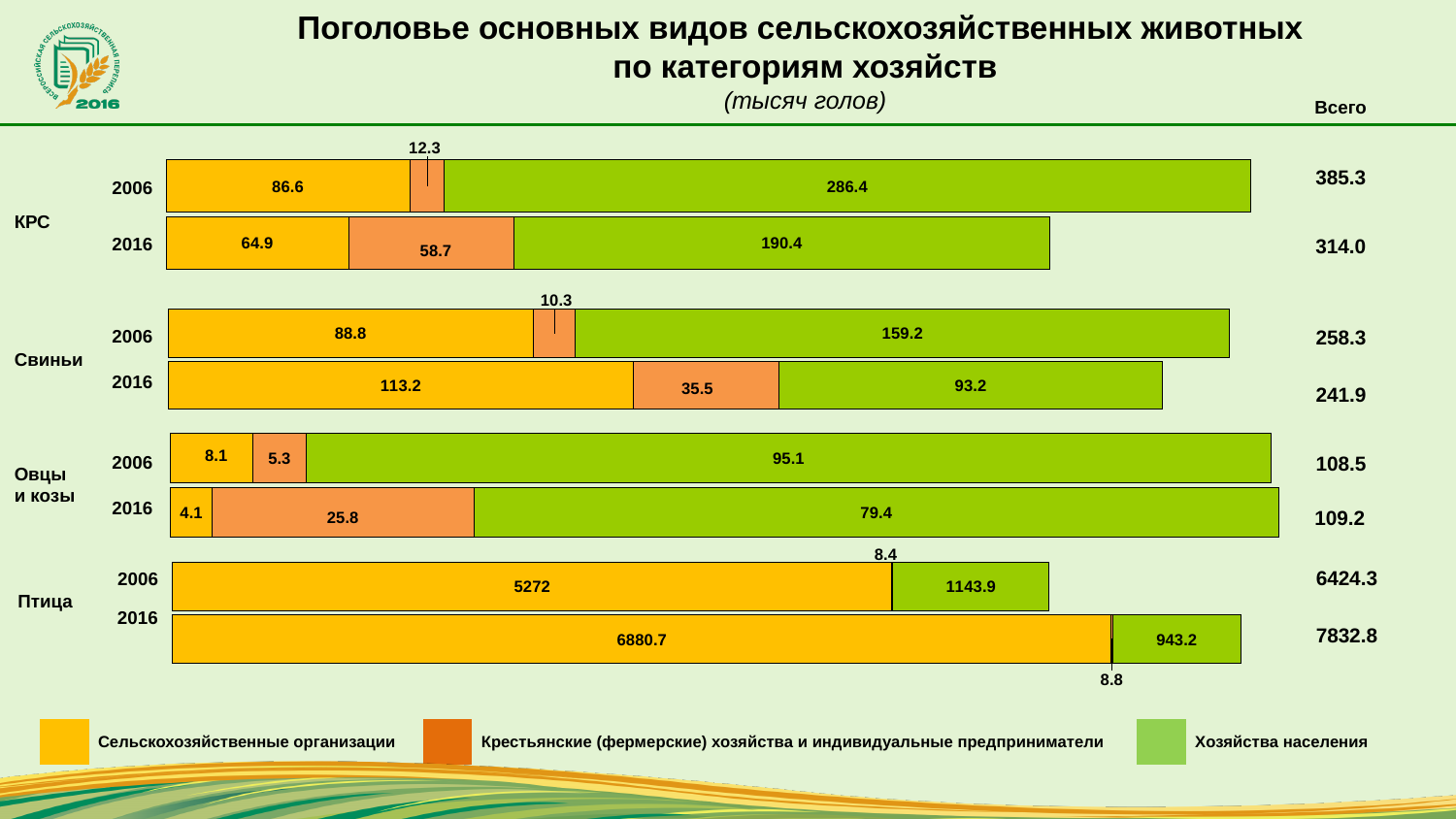
What is the total (Всего) for КРС in 2006? 385.3 Which is larger: the Сельскохозяйственные организации value for Свиньи in 2006 or in 2016? 2016 What is the unit of measurement stated under the chart title? тысяч голов What is the total (Всего) for Птица in 2016? 7832.8 By how much did the Хозяйства населения value for КРС change from 2006 (286.4) to 2016 (190.4)? 96.0 What is the value for Сельскохозяйственные организации in the КРС 2016 bar? 64.9 What is the value for Хозяйства населения in the Свиньи 2006 bar? 159.2 How many series does the legend list? 3 What is the value for Крестьянские (фермерские) хозяйства и индивидуальные предприниматели in the Овцы и козы 2016 bar? 25.8 Which animal category has the lowest total (Всего) in 2006? Овцы и козы Which animal category has the highest total (Всего) in 2016? Птица What kind of chart is shown on the slide? stacked bar chart